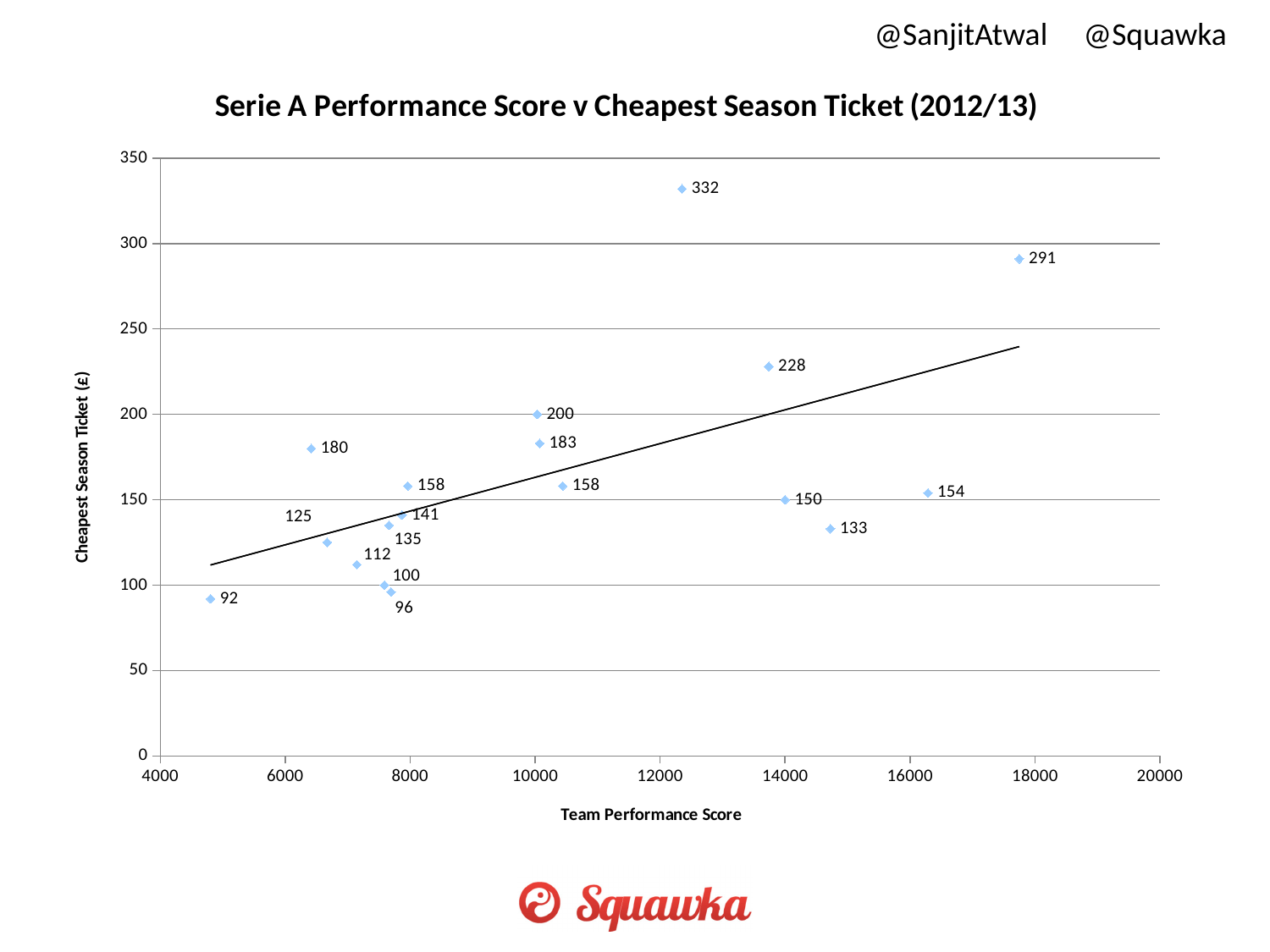
What is the title of the chart? Serie A Performance Score v Cheapest Season Ticket (2012/13) What kind of chart is shown on the slide? scatter chart What is the difference between the two highest labelled season ticket values, 332 and 291? 41 Which is larger: the season ticket value of the point labelled 228 or the point labelled 183? 228 Is the team performance score of the point labelled 291 greater or less than 16000? greater What is the lowest cheapest season ticket value labelled on the chart? 92 Does the trend line rise or fall as the team performance score increases? rises What is the label of the y axis? Cheapest Season Ticket (£) How many data points are plotted on the chart? 18 How many points have a labelled season ticket value greater than 250? 2 Is the team performance score of the point labelled 92 greater or less than 6000? less What is the highest cheapest season ticket value labelled on the chart? 332